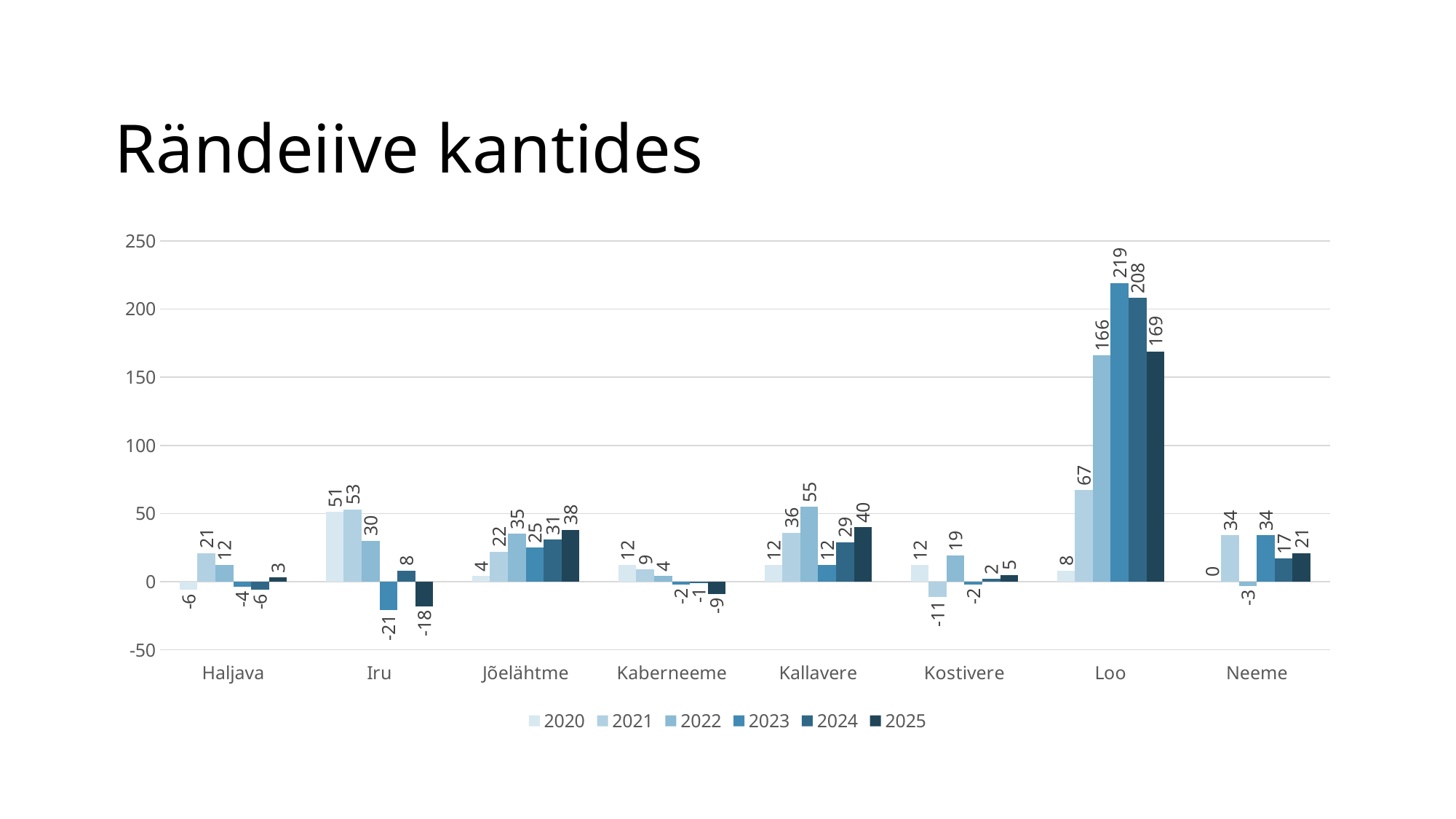
What kind of chart is shown on the slide? Bar chart Which is larger, the 2022 value for Jõelähtme or the 2022 value for Iru? Jõelähtme What is the value for Kallavere in 2022? 55 What is the difference between the 2023 and 2025 values for Loo? 50 What is the value for Loo in 2023? 219 What is the value for Iru in 2023? -21 How many categories are shown on the x axis? 8 How many series does the legend list? 6 What is the value for Neeme in 2020? 0 What is the title of the chart? Rändeiive kantides Which category has the lowest value in 2021? Kostivere Which category has the highest value in 2025? Loo